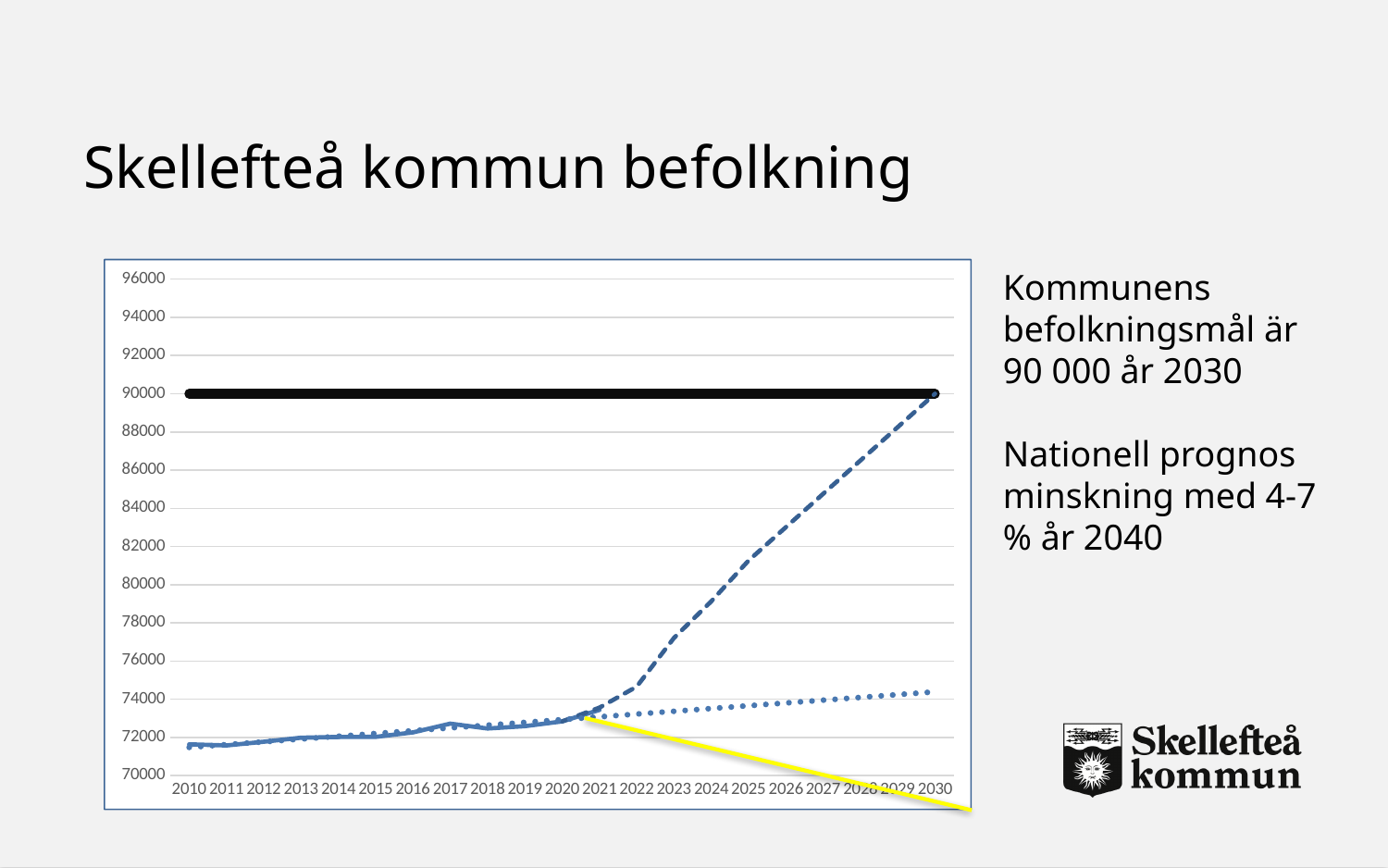
Is the value of the dashed blue line in 2025 greater or less than 80000? greater Is the value of the solid blue line in 2010 greater or less than 72000? less Which line is higher in 2030, the dashed blue line or the dotted blue line? the dashed blue line Does the dashed blue line rise or fall from 2021 to 2030? rise What kind of chart is shown on the slide? line chart Is the value of the dashed blue line in 2022 greater or less than 78000? less What is the last year shown on the x axis of the chart? 2030 How many years are labelled along the x axis of the chart? 21 Does the yellow line rise or fall from 2021 to 2030? fall At what value does the thick black horizontal line sit on the chart? 90000 What is the first year shown on the x axis of the chart? 2010